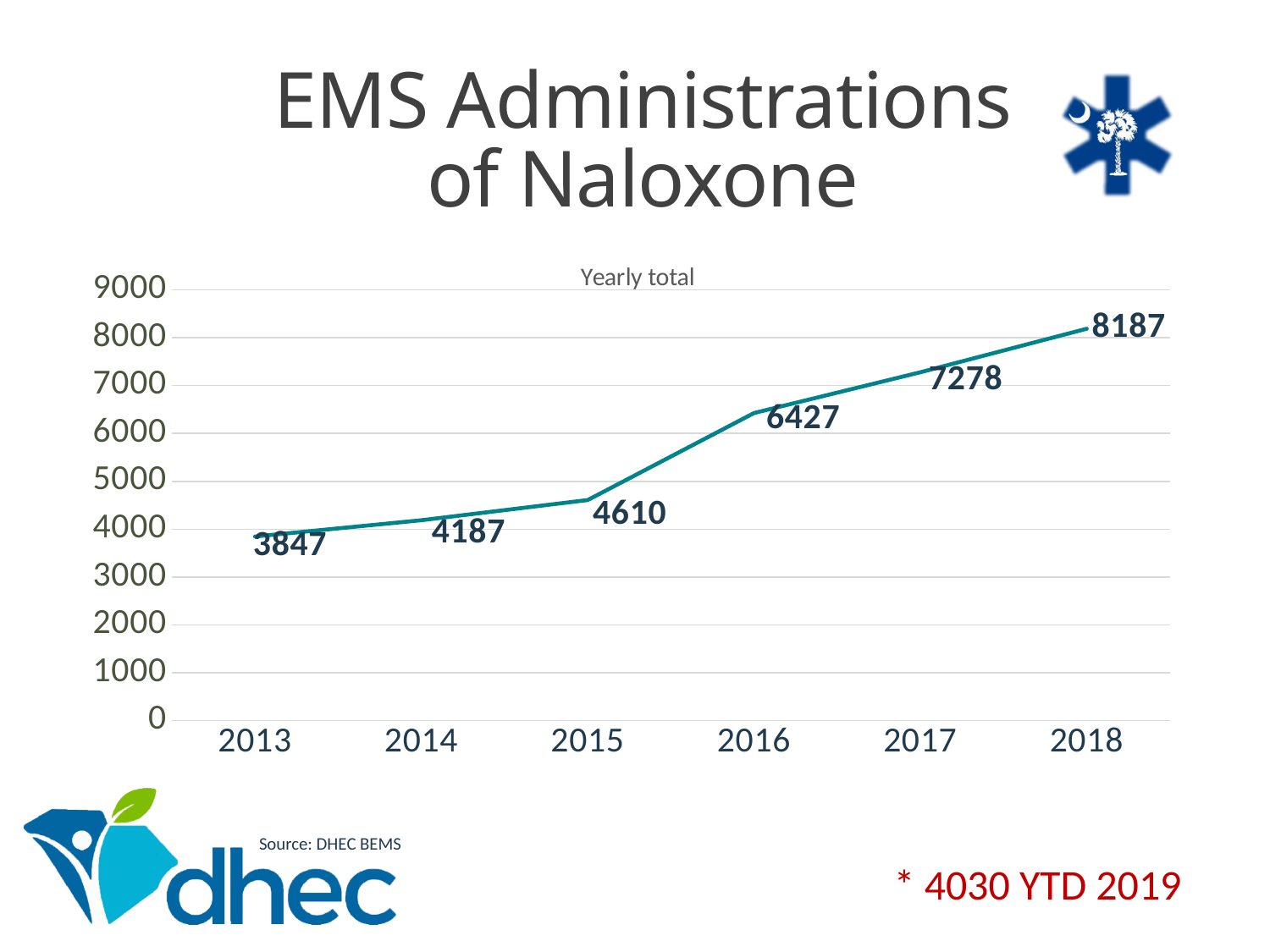
How many years are plotted on the chart? 6 What kind of chart is shown on the slide? Line chart Which year has the highest yearly total? 2018 What is the difference between the 2016 and 2015 yearly totals? 1817 Which is larger, the yearly total for 2014 or for 2015? 2015 What is the difference between the 2018 and 2017 yearly totals? 909 Which year has the lowest yearly total? 2013 What is the yearly total of EMS naloxone administrations for 2016? 6427 What is the yearly total for 2018? 8187 Is the value for 2017 greater or less than 7000? greater What is the yearly total for 2013? 3847 Do the yearly totals rise or fall from 2013 to 2018? Rise